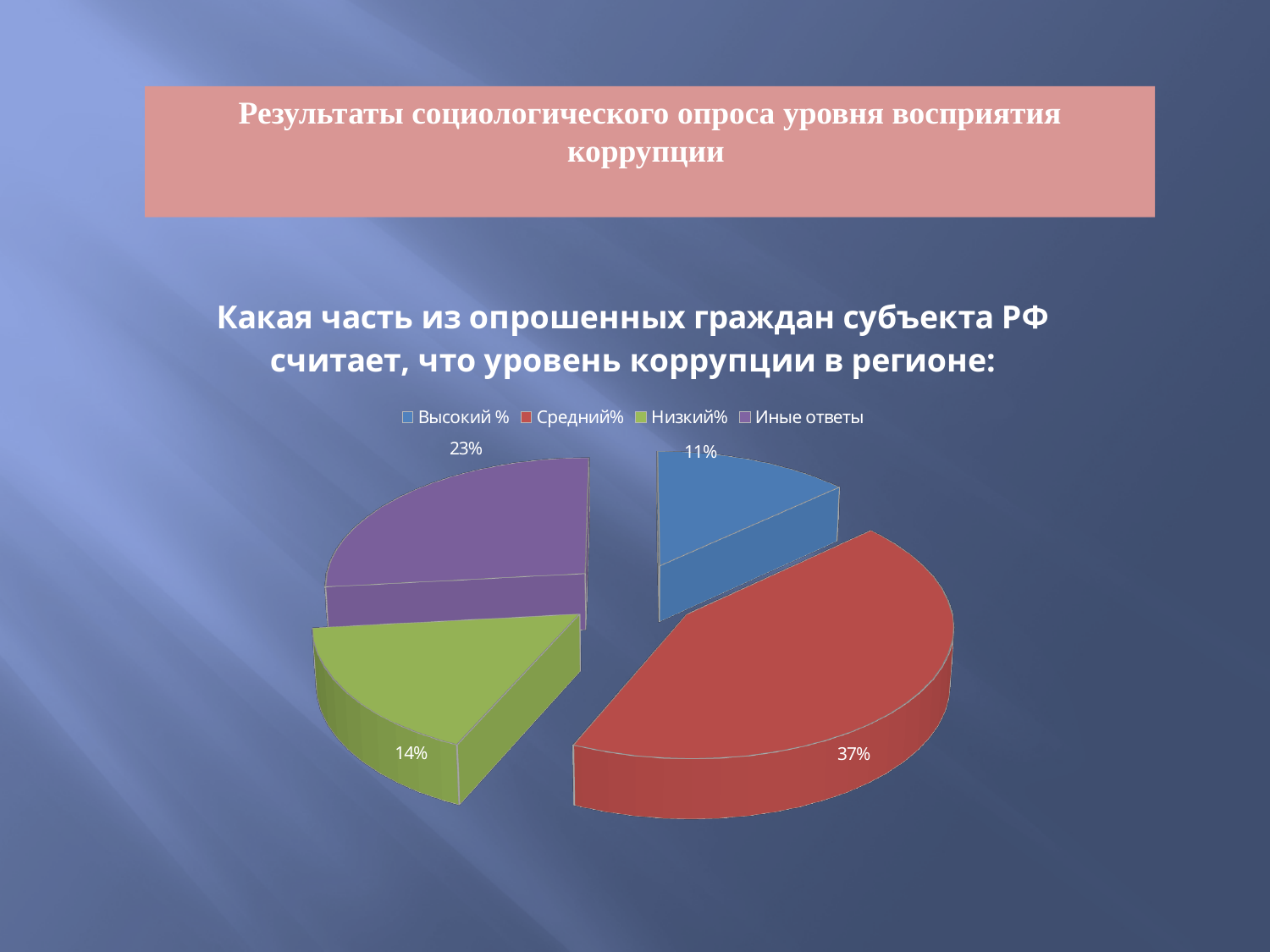
How many slices does the pie chart have? 4 What percentage is shown for the Высокий % slice? 11% Which slice of the pie chart is the smallest? Высокий % What is the difference between the Средний% and Высокий % percentages? 26% What kind of chart is shown on the slide? Pie chart Which slice of the pie chart is the largest? Средний% What percentage is shown for the Низкий% slice? 14% What is the difference between the Иные ответы and Низкий% percentages? 9% What percentage is shown for the Иные ответы slice? 23% What colour is the Средний% slice in the pie chart? Red Which is larger, the Иные ответы slice or the Низкий% slice? Иные ответы What percentage is shown for the Средний% slice? 37%